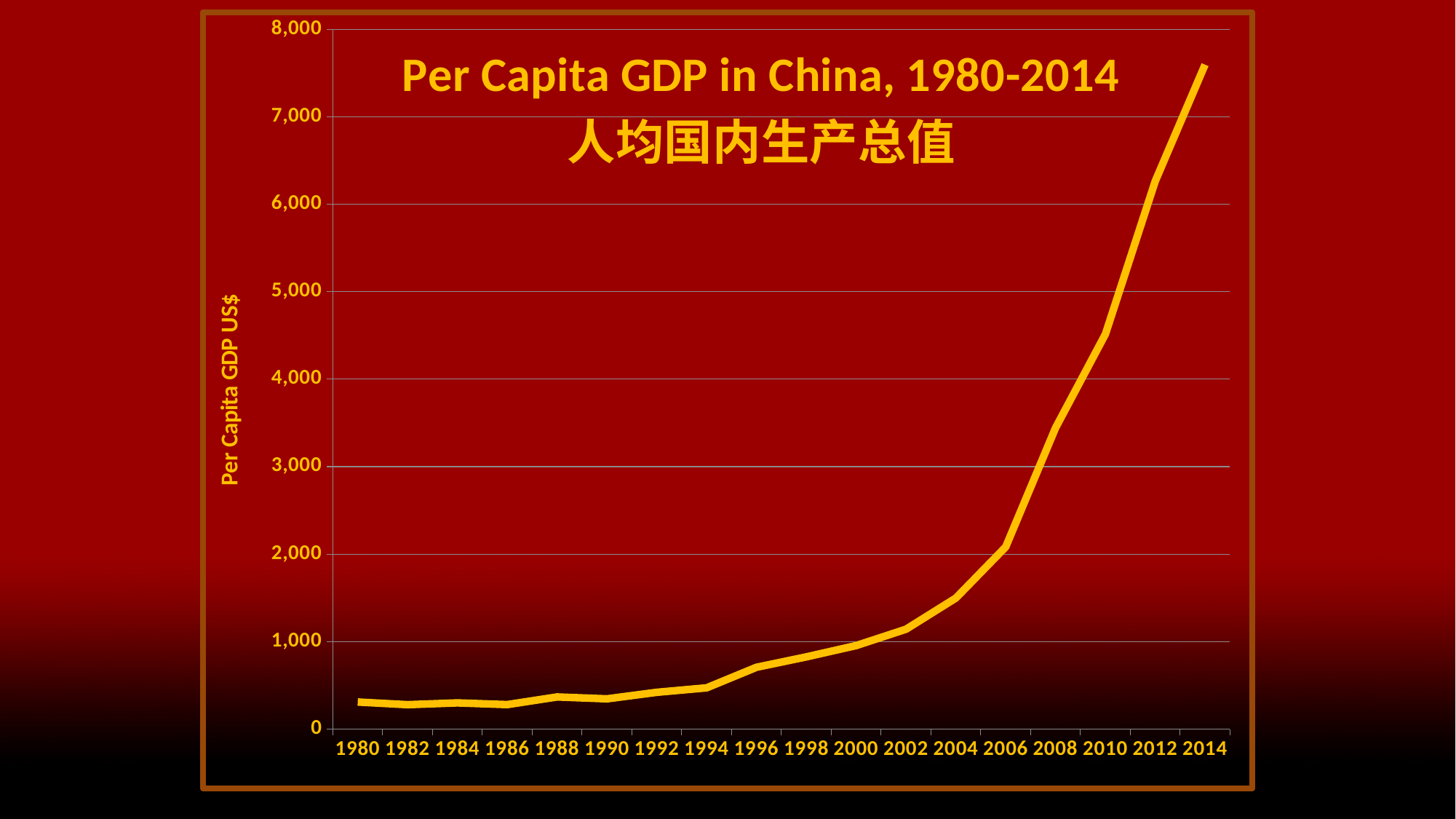
How many year labels are shown on the horizontal axis? 18 Is the value for 2012 greater or less than 6,000? greater Is the value for 2014 greater or less than 7,000? greater What is the title of the chart? Per Capita GDP in China, 1980-2014 人均国内生产总值 Which year has the highest per capita GDP? 2014 What is the label on the vertical axis? Per Capita GDP US$ Is the value for 2010 greater or less than 4,000? greater Which is larger, the value for 2010 or the value for 2006? 2010 What kind of chart is shown on the slide? line chart Do the values rise or fall from 1980 to 2014? rise